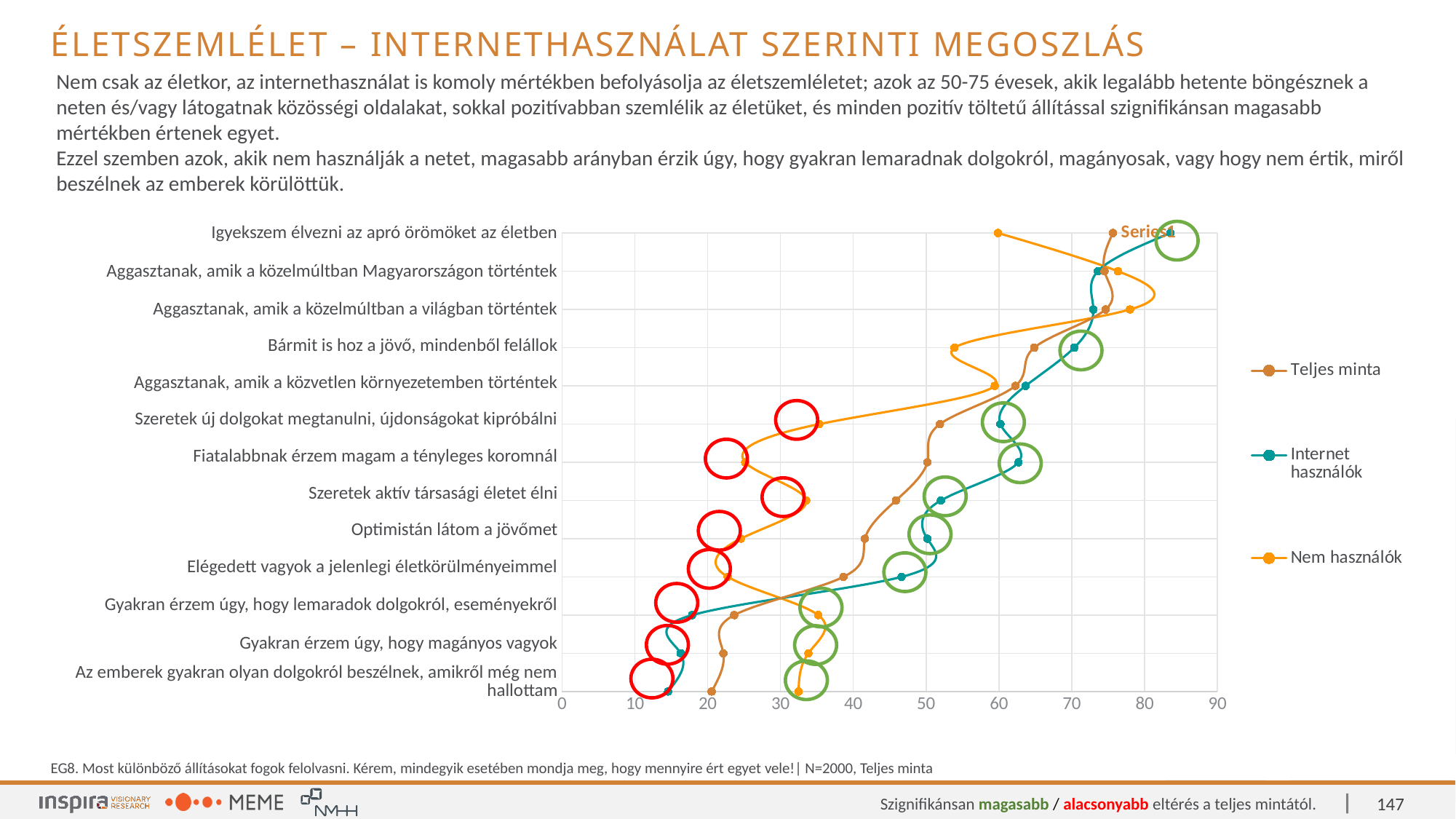
For 'Gyakran érzem úgy, hogy lemaradok dolgokról, eseményekről', which series has the larger value: Internet használók or Nem használók? Nem használók Which series are listed in the chart legend? Teljes minta, Internet használók, Nem használók Is the value for 'Igyekszem élvezni az apró örömöket az életben' for Nem használók greater or less than 50? greater Is the value for 'Az emberek gyakran olyan dolgokról beszélnek, amikről még nem hallottam' for Internet használók greater or less than 20? less Is the value for 'Gyakran érzem úgy, hogy magányos vagyok' for Nem használók greater or less than 30? greater What kind of chart is shown on the slide? line chart Which statement has the highest value for the Internet használók series? Igyekszem élvezni az apró örömöket az életben For 'Igyekszem élvezni az apró örömöket az életben', which series has the larger value: Internet használók or Nem használók? Internet használók How many statements (categories) are plotted on the chart? 13 How many series does the legend list? 3